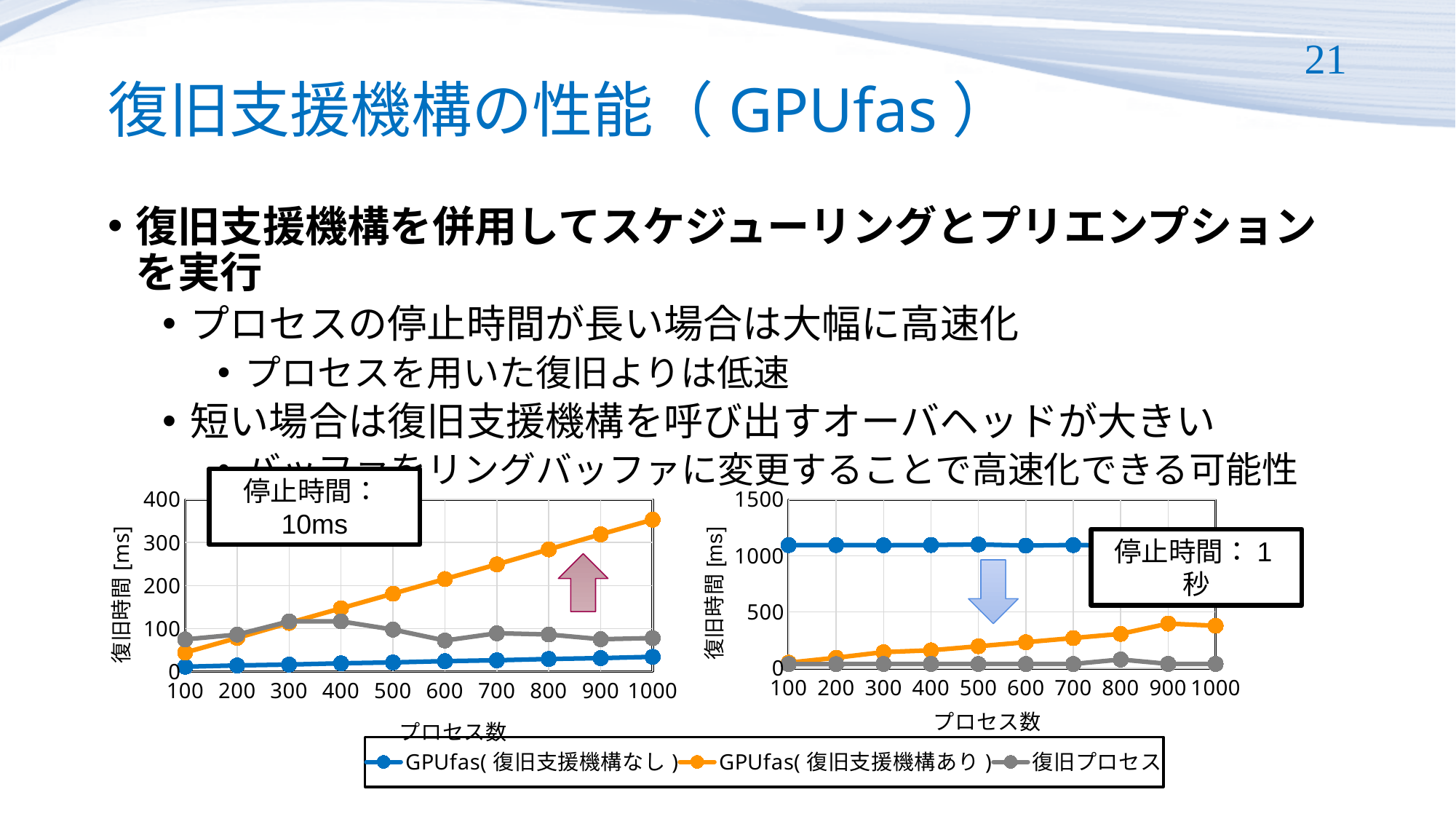
What is the x-axis label of the right chart (停止時間: 1秒)? プロセス数 In the right chart (停止時間: 1秒), at プロセス数 1000, which is larger: GPUfas(復旧支援機構なし) or GPUfas(復旧支援機構あり)? GPUfas(復旧支援機構なし) In the left chart (停止時間: 10ms), which series has the highest value at プロセス数 1000? GPUfas(復旧支援機構あり) In the right chart (停止時間: 1秒), which series has the lowest value at プロセス数 1000? 復旧プロセス In the left chart (停止時間: 10ms), is the value for GPUfas(復旧支援機構あり) at プロセス数 1000 greater or less than 300? greater In the right chart (停止時間: 1秒), is the value for GPUfas(復旧支援機構なし) at プロセス数 100 greater or less than 1000? greater How many series does the legend list? 3 What kind of chart is the left chart (停止時間: 10ms)? line chart In the left chart (停止時間: 10ms), does the GPUfas(復旧支援機構あり) series rise or fall as プロセス数 increases? rise In the left chart (停止時間: 10ms), is the value for GPUfas(復旧支援機構なし) at プロセス数 1000 greater or less than 100? less In the left chart (停止時間: 10ms), at プロセス数 100, which is larger: 復旧プロセス or GPUfas(復旧支援機構あり)? 復旧プロセス In the left chart (停止時間: 10ms), how many x-axis points (プロセス数 values) are plotted for each series? 10